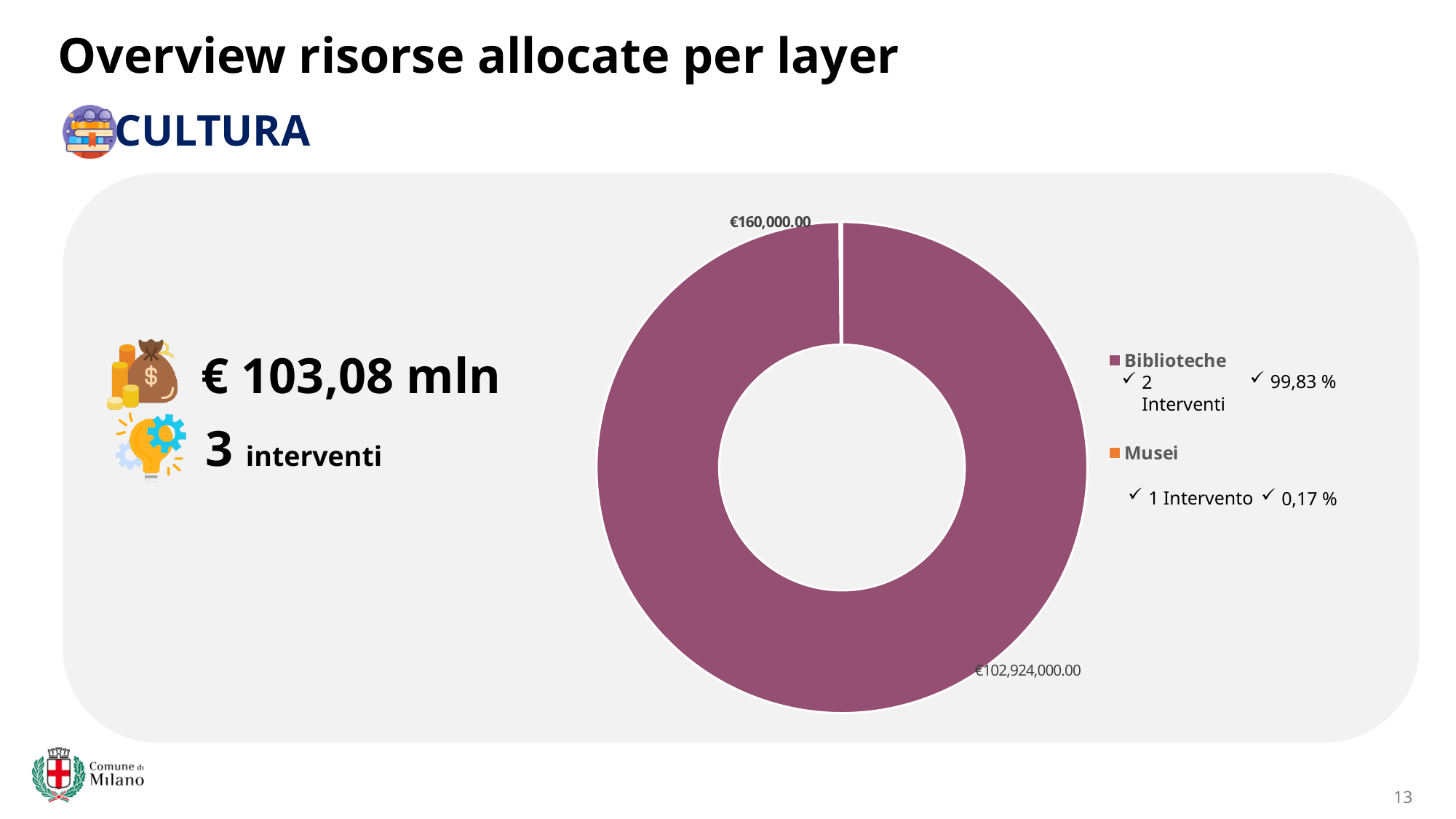
What share of the total does the Biblioteche slice represent? 99,83 % Which category has the largest slice in the chart? Biblioteche What is the value of the Biblioteche slice in the donut chart? €102,924,000.00 What is the value of the Musei slice in the donut chart? €160,000.00 What is the combined total of the two slices in the chart? €103,084,000.00 Which is larger, the value for Biblioteche or the value for Musei? Biblioteche What kind of chart is shown on the slide? donut chart What is the difference between the Biblioteche value and the Musei value? €102,764,000.00 How many entries does the chart legend list? 2 How many slices does the donut chart have? 2 What share of the total does the Musei slice represent? 0,17 % Which category has the smallest slice in the chart? Musei